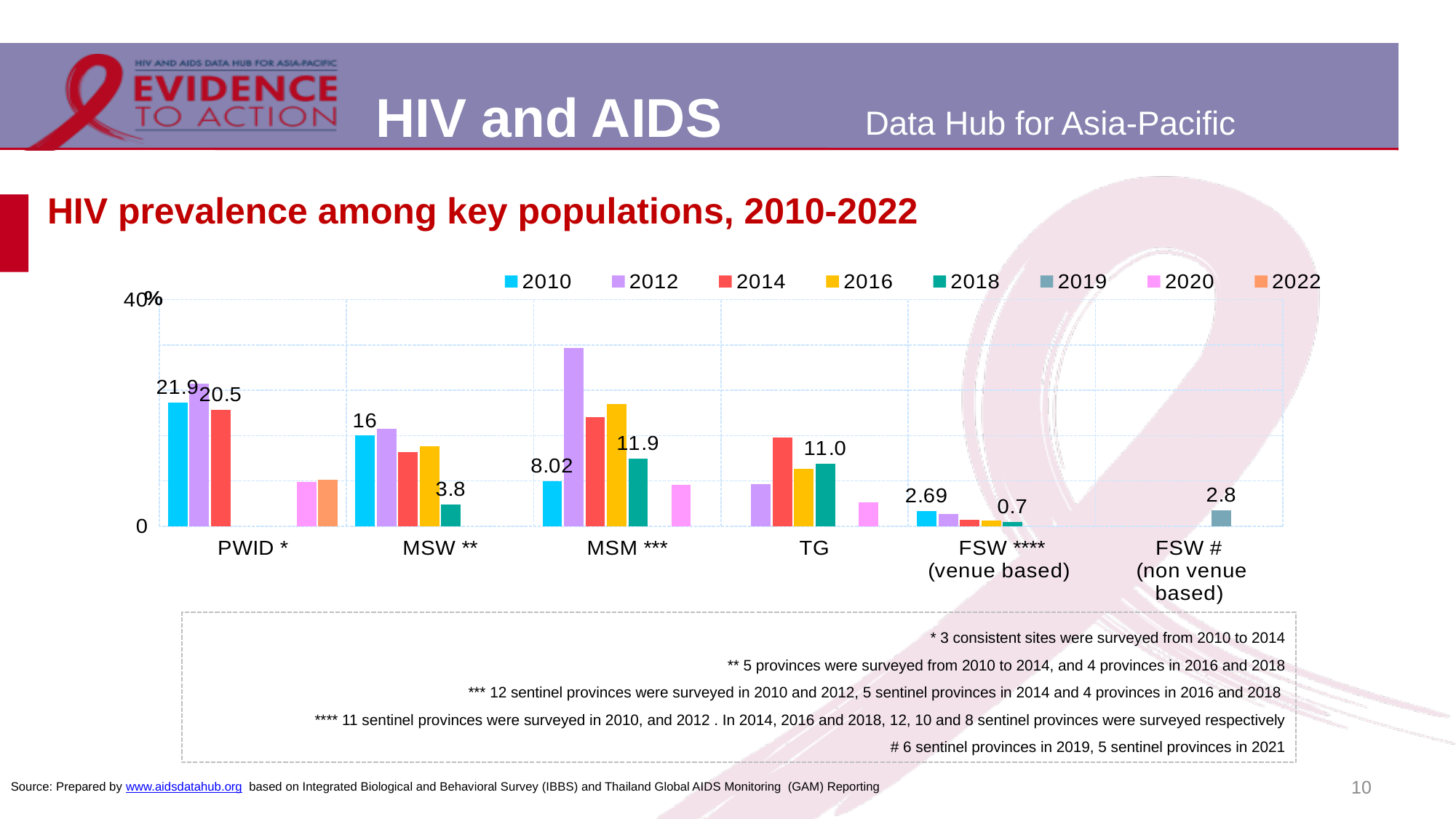
What is the HIV prevalence among TG in 2018? 11.0 By how much did HIV prevalence among MSW fall from 2010 (16) to 2018 (3.8)? 12.2 What kind of chart is shown on the slide? bar chart What is the HIV prevalence among FSW (venue based) in 2010? 2.69 Which year shows the highest HIV prevalence among MSM? 2012 What is the HIV prevalence among MSM in 2018? 11.9 What is the HIV prevalence among FSW (non venue based) in 2019? 2.8 How many key population categories are shown on the x axis? 6 Which is larger: HIV prevalence among MSW in 2010 or among MSM in 2010? MSW in 2010 Is the 2012 value for MSM greater or less than 40? less What is the HIV prevalence among MSW in 2010? 16 How many series does the legend list? 8